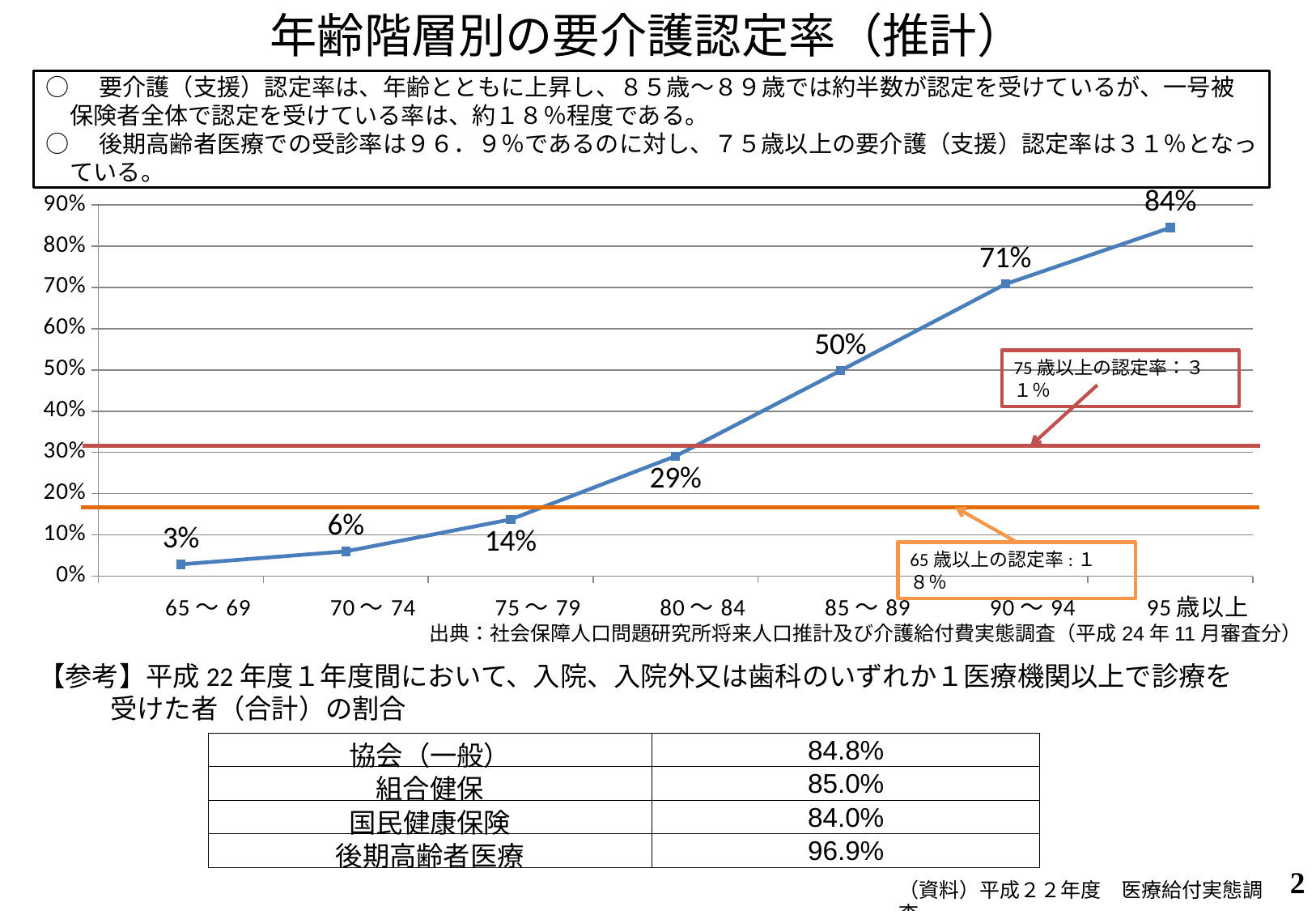
What is the certification rate for the 65〜69 age group? 3% What is the difference in percentage points between the 85〜89 group (50%) and the 80〜84 group (29%)? 21 percentage points Does the certification rate rise or fall as age increases along the x axis? rises What is the certification rate (要介護認定率) for the 85〜89 age group? 50% Which age group has the highest certification rate? 95歳以上 According to the red reference line label, what is the certification rate for people aged 75 and over? 31% What is the certification rate for the 75〜79 age group? 14% What is the certification rate for the 90〜94 age group? 71% Which age group has the lowest certification rate? 65〜69 What kind of chart is shown on the slide? line chart Which has the larger certification rate, the 70〜74 group or the 80〜84 group? 80〜84 How many age groups are plotted on the x axis? 7